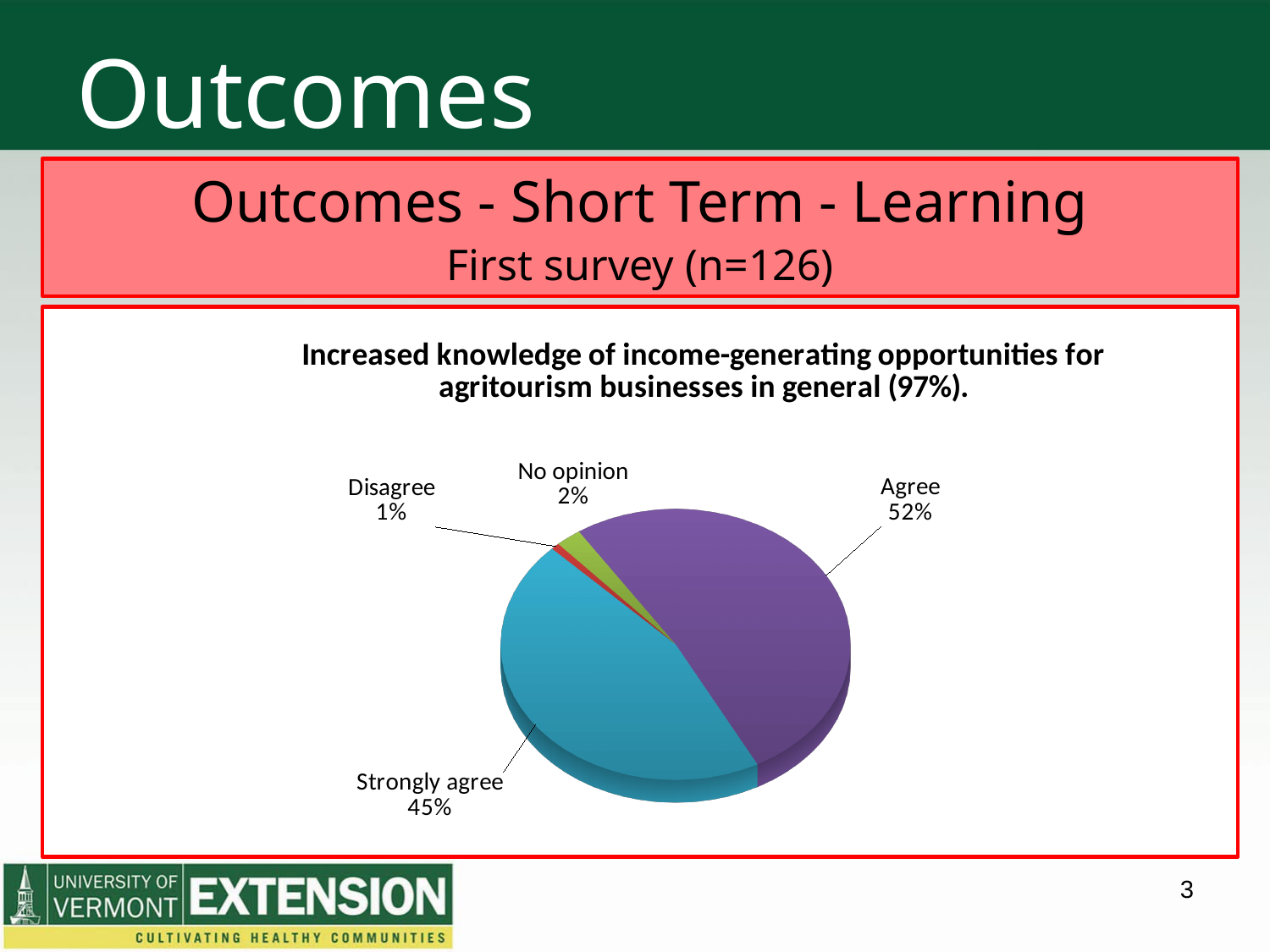
What kind of chart is shown on the slide? Pie chart Which response category has the largest share of the pie? Agree What colour is the "Strongly agree" slice? Blue What percentage of respondents answered "Agree"? 52% What is the combined share of "Agree" and "Strongly agree"? 97% Which response category has the smallest share of the pie? Disagree How many response categories are shown in the pie chart? 4 What percentage of respondents answered "No opinion"? 2% What percentage of respondents answered "Disagree"? 1% Which is larger, the share for "No opinion" or the share for "Disagree"? No opinion What percentage of respondents answered "Strongly agree"? 45% What is the difference in percentage points between "Agree" and "Strongly agree"? 7